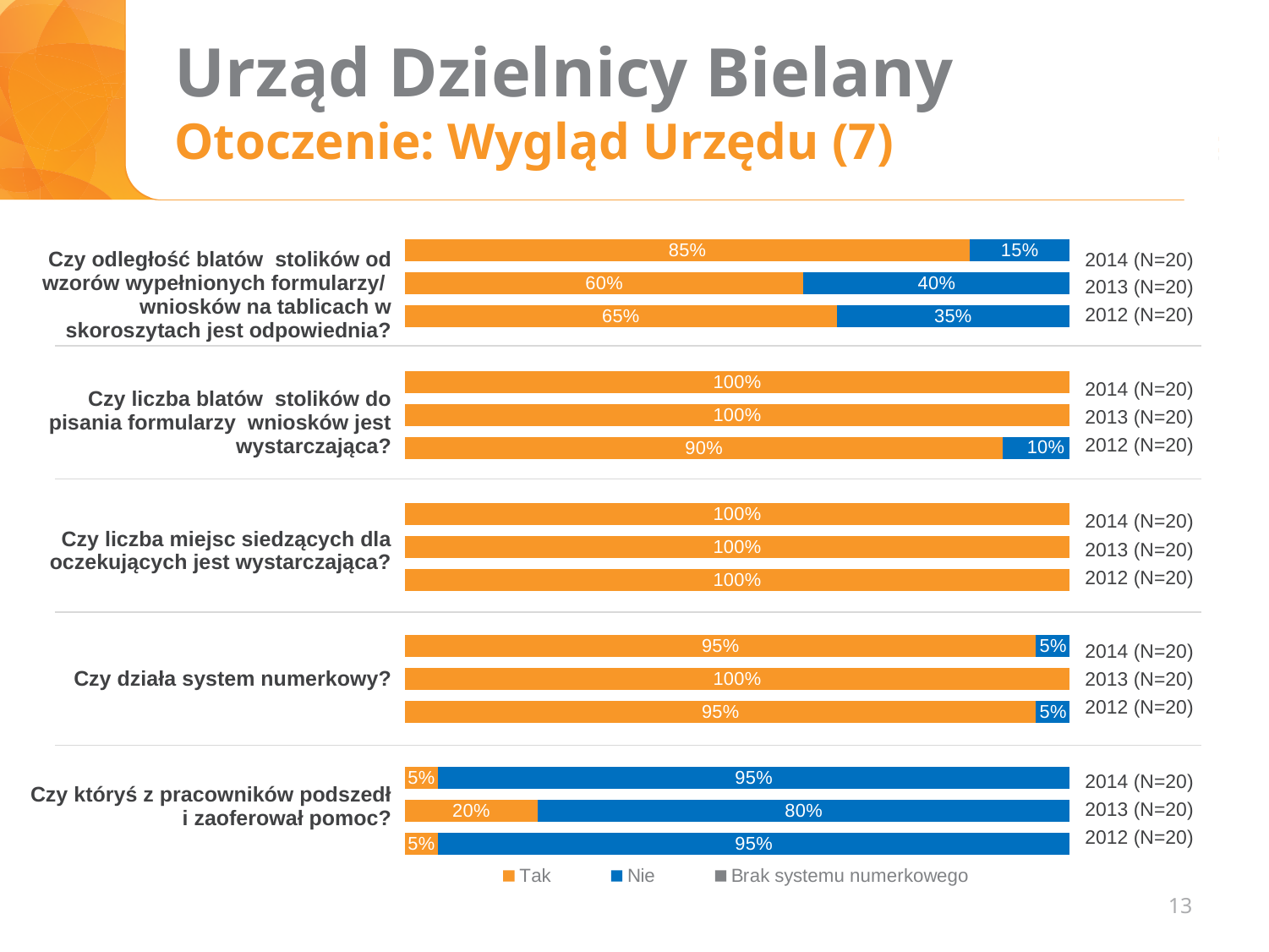
In the chart for "Czy odległość blatów stolików od wzorów wypełnionych formularzy/wniosków na tablicach w skoroszytach jest odpowiednia?", what is the difference between the "Tak" values for 2014 and 2013? 25% In the chart for "Czy odległość blatów stolików od wzorów wypełnionych formularzy/wniosków na tablicach w skoroszytach jest odpowiednia?", which year has the highest "Tak" value? 2014 (N=20) How many series does the legend at the bottom of the slide list? 3 In the chart for "Czy odległość blatów stolików od wzorów wypełnionych formularzy/wniosków na tablicach w skoroszytach jest odpowiednia?", what is the "Nie" value for 2013 (N=20)? 40% In the chart for "Czy odległość blatów stolików od wzorów wypełnionych formularzy/wniosków na tablicach w skoroszytach jest odpowiednia?", what is the "Tak" value for 2014 (N=20)? 85% In the chart for "Czy któryś z pracowników podszedł i zaoferował pomoc?", what is the total of the 2014 (N=20) stacked bar? 100% In the chart for "Czy działa system numerkowy?", is the "Tak" value for 2013 larger or smaller than the "Tak" value for 2012? larger In the chart for "Czy któryś z pracowników podszedł i zaoferował pomoc?", what is the "Nie" value for 2013 (N=20)? 80% In the chart for "Czy liczba blatów stolików do pisania formularzy wniosków jest wystarczająca?", which year has the lowest "Tak" value? 2012 (N=20) In the chart for "Czy liczba miejsc siedzących dla oczekujących jest wystarczająca?", what is the "Tak" value for 2013 (N=20)? 100% In the chart for "Czy działa system numerkowy?", what is the "Nie" value for 2014 (N=20)? 5% In the chart for "Czy liczba blatów stolików do pisania formularzy wniosków jest wystarczająca?", what is the "Nie" value for 2012 (N=20)? 10%